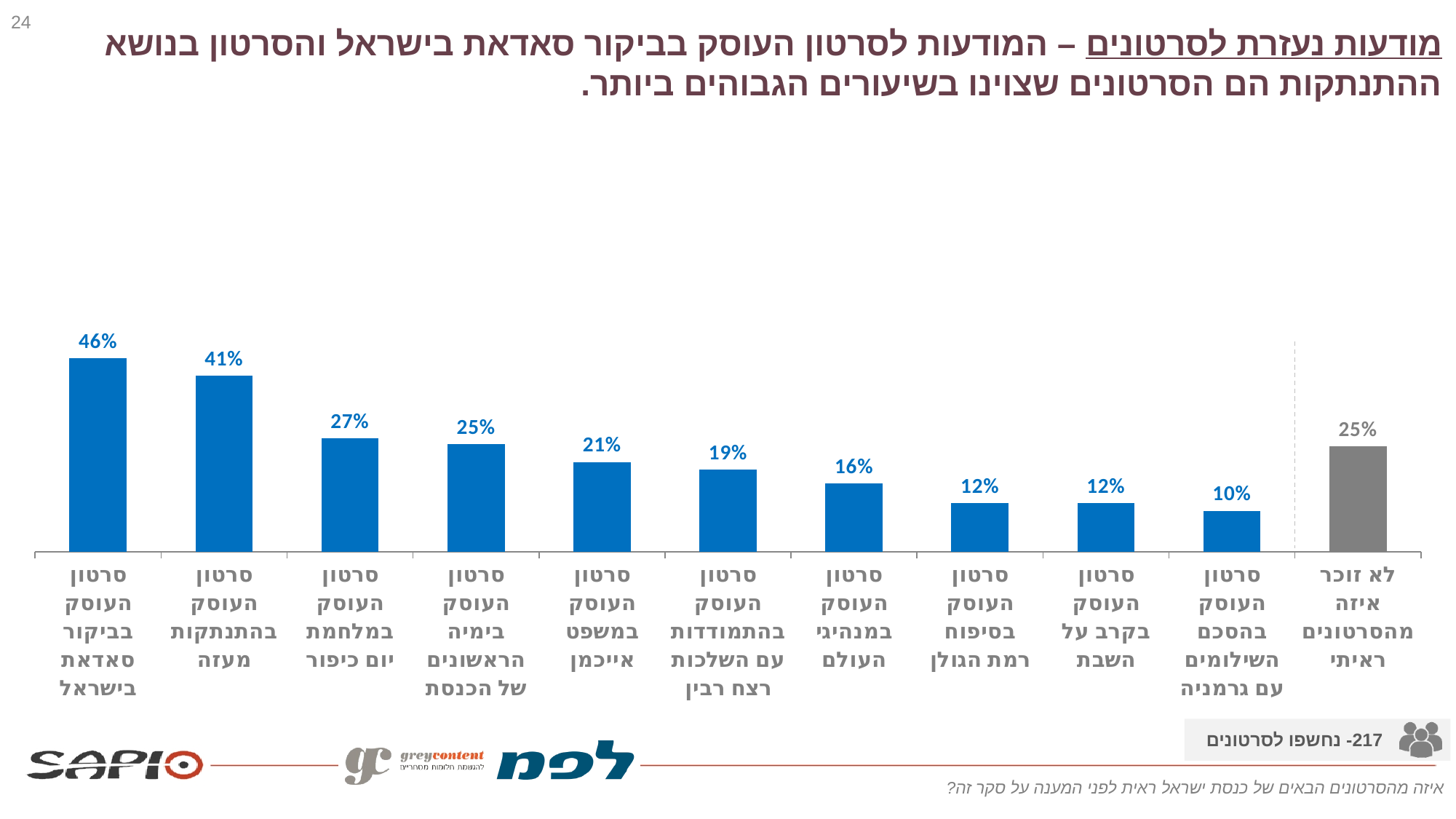
What is the difference between the values for 'סרטון העוסק בהתמודדות עם השלכות רצח רבין' and 'סרטון העוסק בסיפוח רמת הגולן'? 7% What is the value for the grey bar labelled 'לא זוכר איזה מהסרטונים ראיתי'? 25% What is the value for the bar labelled 'סרטון העוסק בביקור סאדאת בישראל'? 46% What is the difference between the values for 'סרטון העוסק בביקור סאדאת בישראל' and 'סרטון העוסק בהתנתקות מעזה'? 5% How many bars (categories) does the chart show? 11 What kind of chart is shown on the slide? bar chart Which category has the lowest value in the chart? סרטון העוסק בהסכם השילומים עם גרמניה What colour is the bar for 'לא זוכר איזה מהסרטונים ראיתי', which is separated from the others by a dashed line? grey Which category has the highest value in the chart? סרטון העוסק בביקור סאדאת בישראל What is the value for the bar labelled 'סרטון העוסק בהתנתקות מעזה'? 41% What is the value for the bar labelled 'סרטון העוסק במשפט אייכמן'? 21% Which is larger: the value for 'סרטון העוסק במלחמת יום כיפור' or the value for 'סרטון העוסק במנהיגי העולם'? סרטון העוסק במלחמת יום כיפור